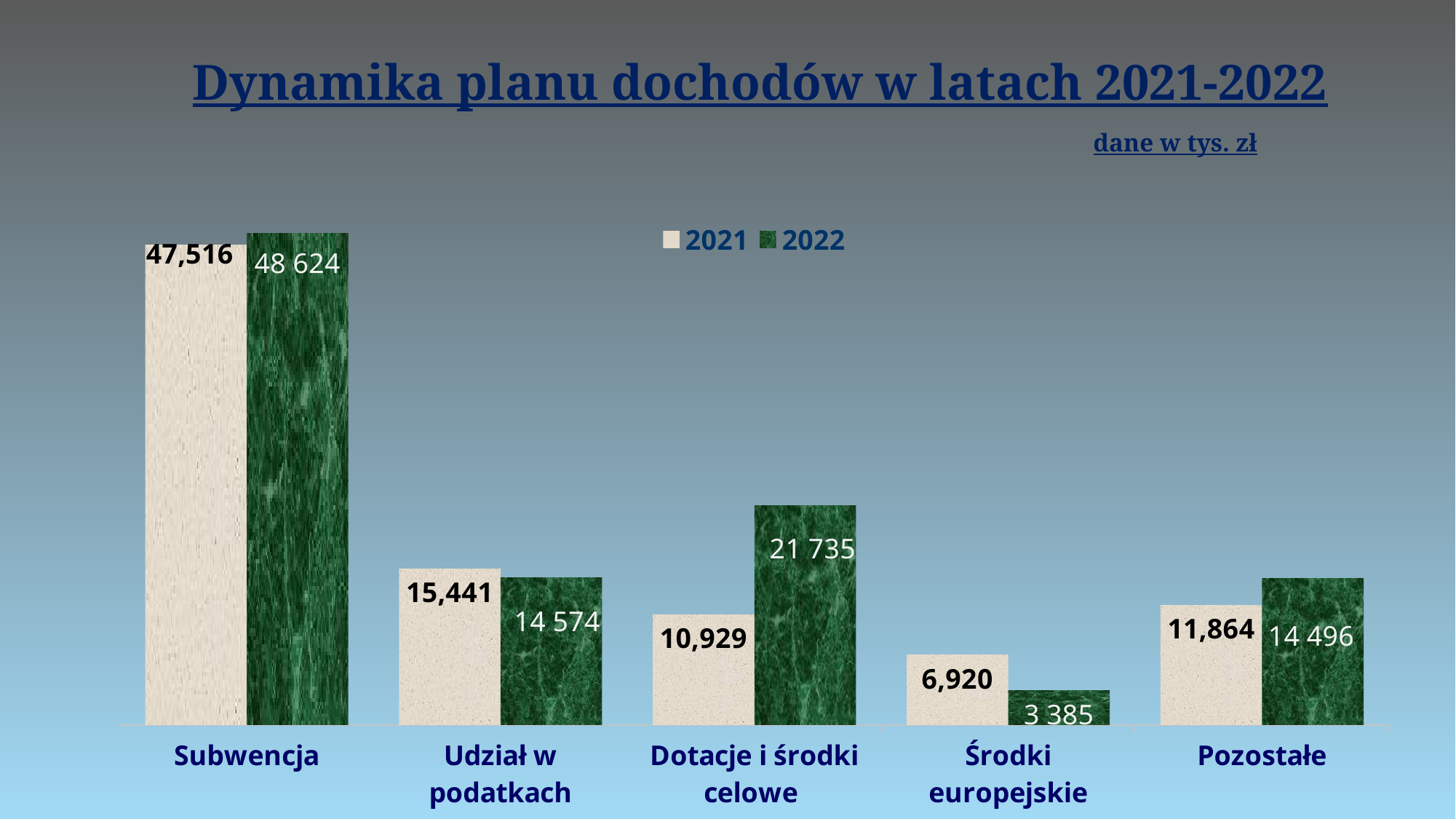
What is the 2021 value for Pozostałe? 11,864 Which category has the lowest 2021 value? Środki europejskie What is the 2021 value for Subwencja? 47,516 Which category has the highest 2022 value? Subwencja For Udział w podatkach, which year has the larger value, 2021 or 2022? 2021 What is the difference between the 2021 and 2022 values for Środki europejskie? 3 535 How many series does the legend list? 2 What is the 2022 value for Dotacje i środki celowe? 21 735 What is the difference between the 2022 and 2021 values for Dotacje i środki celowe? 10 806 What is the 2022 value for Środki europejskie? 3 385 What kind of chart is shown on the slide? Bar chart How many categories are shown on the x axis? 5